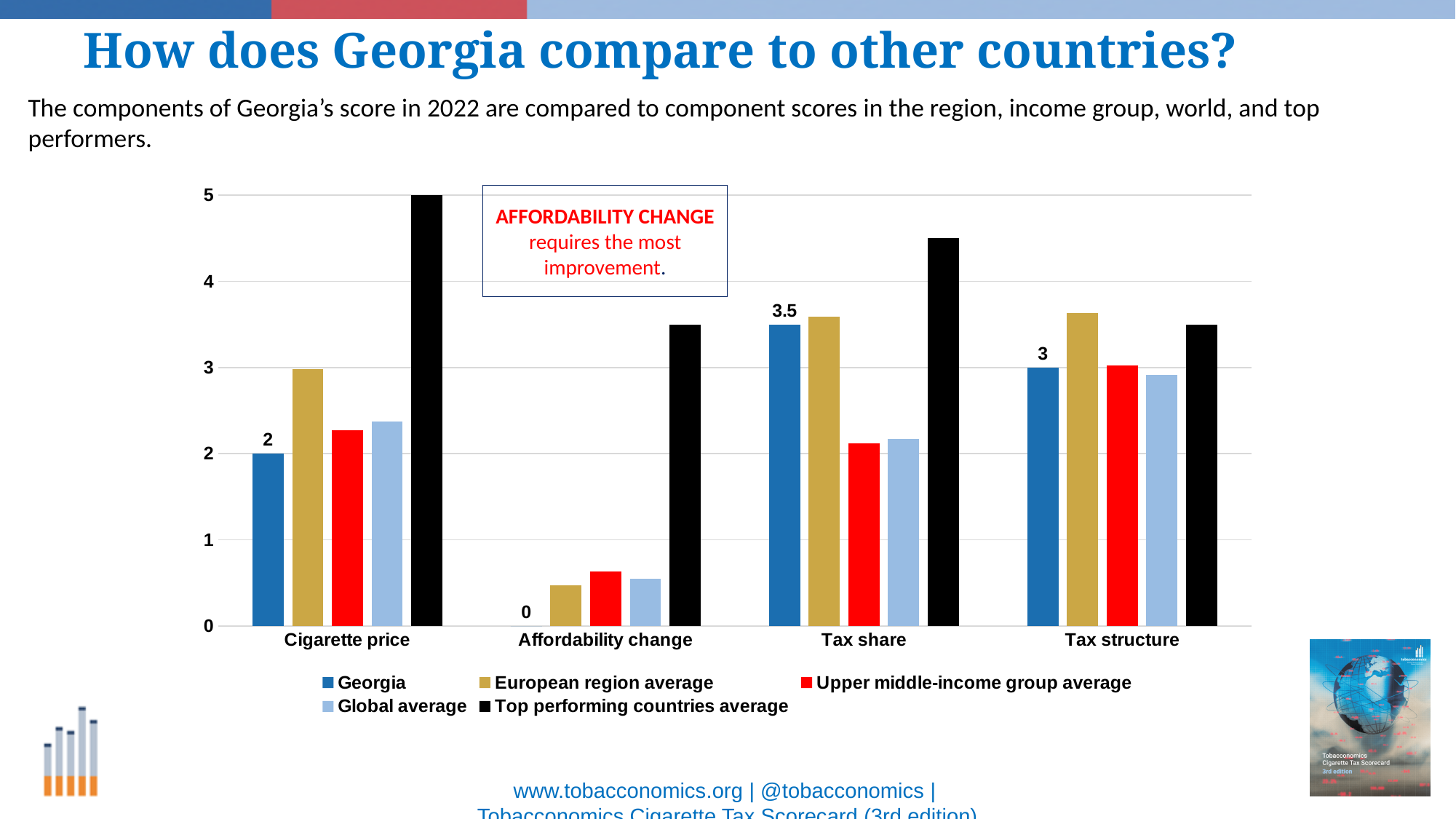
In which component does Georgia have its highest score? Tax share What is Georgia's score for Tax share? 3.5 What is Georgia's score for Affordability change? 0 How many components are shown on the x axis? 4 What is Georgia's score for Cigarette price? 2 What kind of chart is shown on the slide? Bar chart How many series does the legend list? 5 Is the Top performing countries average for Tax share greater or less than 4? greater What is the difference between Georgia's Tax share score and its Cigarette price score? 1.5 In which component does Georgia have its lowest score? Affordability change What is Georgia's score for Tax structure? 3 For Cigarette price, which is larger: Georgia or the European region average? European region average